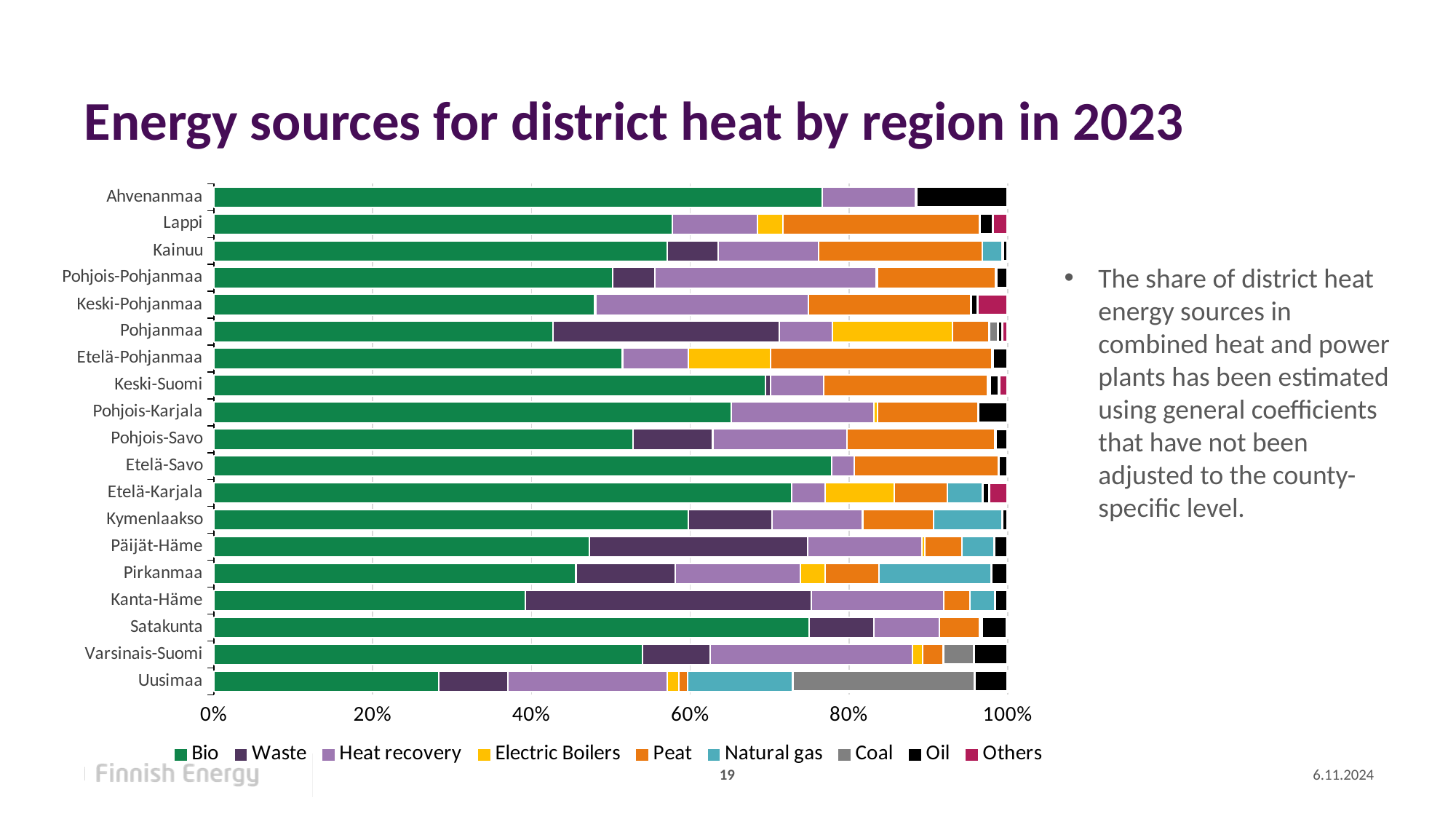
Is the Bio share for Pohjanmaa greater or less than 60%? less What is the title of the chart? Energy sources for district heat by region in 2023 What kind of chart is shown on the slide? Stacked bar chart Is the Bio share for Uusimaa greater or less than 40%? less Which energy source is shown in green in the chart? Bio How many regions are shown on the chart? 19 Which region has the lowest share of Bio? Uusimaa Is the Bio share for Ahvenanmaa greater or less than 60%? greater Which region has the largest share of Coal? Uusimaa Which region has the largest share of Waste? Kanta-Häme Which region has a larger share of Bio, Ahvenanmaa or Uusimaa? Ahvenanmaa How many energy sources does the legend list? 9